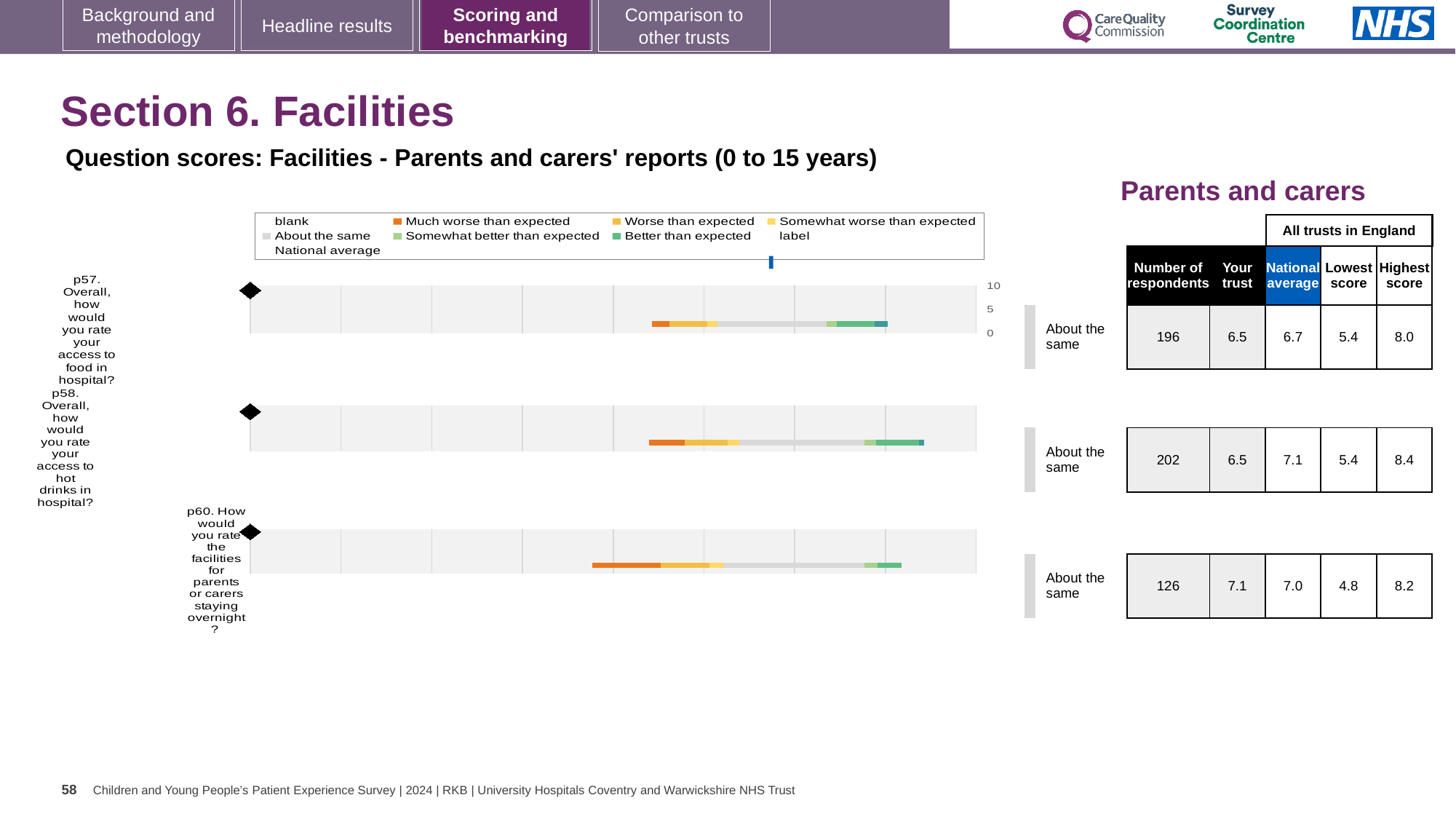
For p60, which is larger: the 'Your trust' score or the national average? Your trust What benchmark category is shown for all three Facilities questions? About the same What is the national average score for p58 (access to hot drinks in hospital)? 7.1 For p58, what is the difference between the national average and the 'Your trust' score? 0.6 How many respondents answered p60 (facilities for parents or carers staying overnight)? 126 What is the highest score among all trusts in England for p58? 8.4 Which question has the highest 'Your trust' score? p60 Is the 'Your trust' score for p57 greater or less than 5 on the chart axis? greater Which question has the lowest national average score? p57 How many questions (rows) are plotted in the Facilities benchmark charts? 3 What is the 'Your trust' score for p57 (access to food in hospital)? 6.5 What kind of chart is used to show the question scores for Facilities? Bar chart